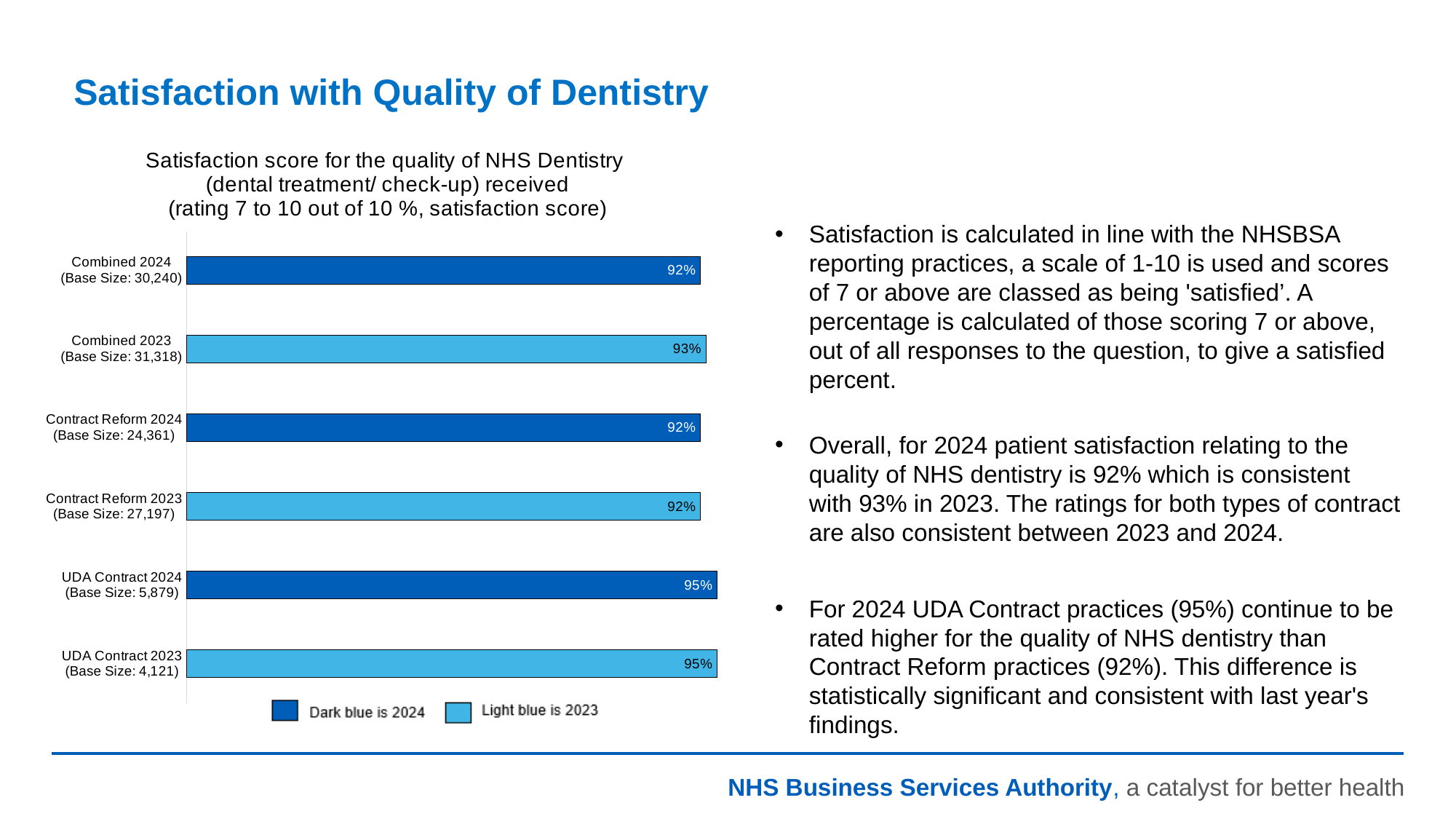
What is the difference between the satisfaction scores for UDA Contract 2024 and Contract Reform 2024? 3% According to the legend, which year do the dark blue bars represent? 2024 Which has a higher satisfaction score, UDA Contract 2024 or Contract Reform 2024? UDA Contract 2024 What is the satisfaction score for Combined 2024? 92% What is the satisfaction score for UDA Contract 2024? 95% How many bars are shown in the chart? 6 What is the base size shown for UDA Contract 2023? 4,121 What is the satisfaction score for Combined 2023? 93% What type of chart is shown on the slide? Bar chart How many entries does the chart legend list? 2 What is the difference between the satisfaction scores for Combined 2023 and Combined 2024? 1% What is the satisfaction score for Contract Reform 2023? 92%